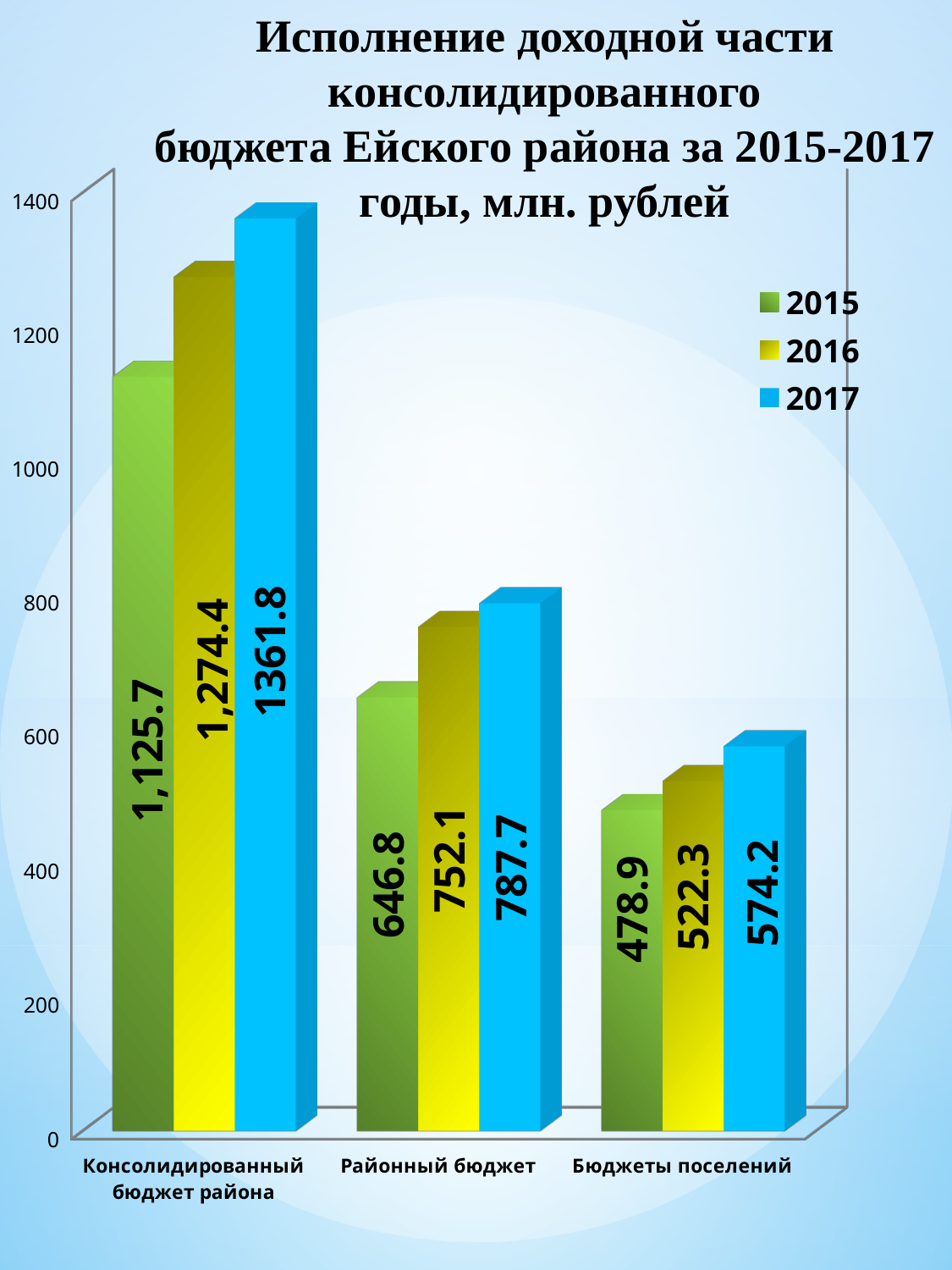
What is the value for Районный бюджет in 2016? 752.1 How many series does the legend list? 3 Is the 2017 value for Консолидированный бюджет района greater or less than 1200? greater How many categories are shown on the x axis? 3 Which category has the lowest value in 2015? Бюджеты поселений Which category has the highest value in 2017? Консолидированный бюджет района What is the value for Консолидированный бюджет района in 2015? 1,125.7 What kind of chart is shown on the slide? bar chart Which is larger: the 2016 value for Районный бюджет or the 2017 value for Бюджеты поселений? 2016 value for Районный бюджет What is the difference between the 2017 and 2016 values for Бюджеты поселений? 51.9 Which colour represents the 2017 series in the legend? blue What is the value for Бюджеты поселений in 2017? 574.2